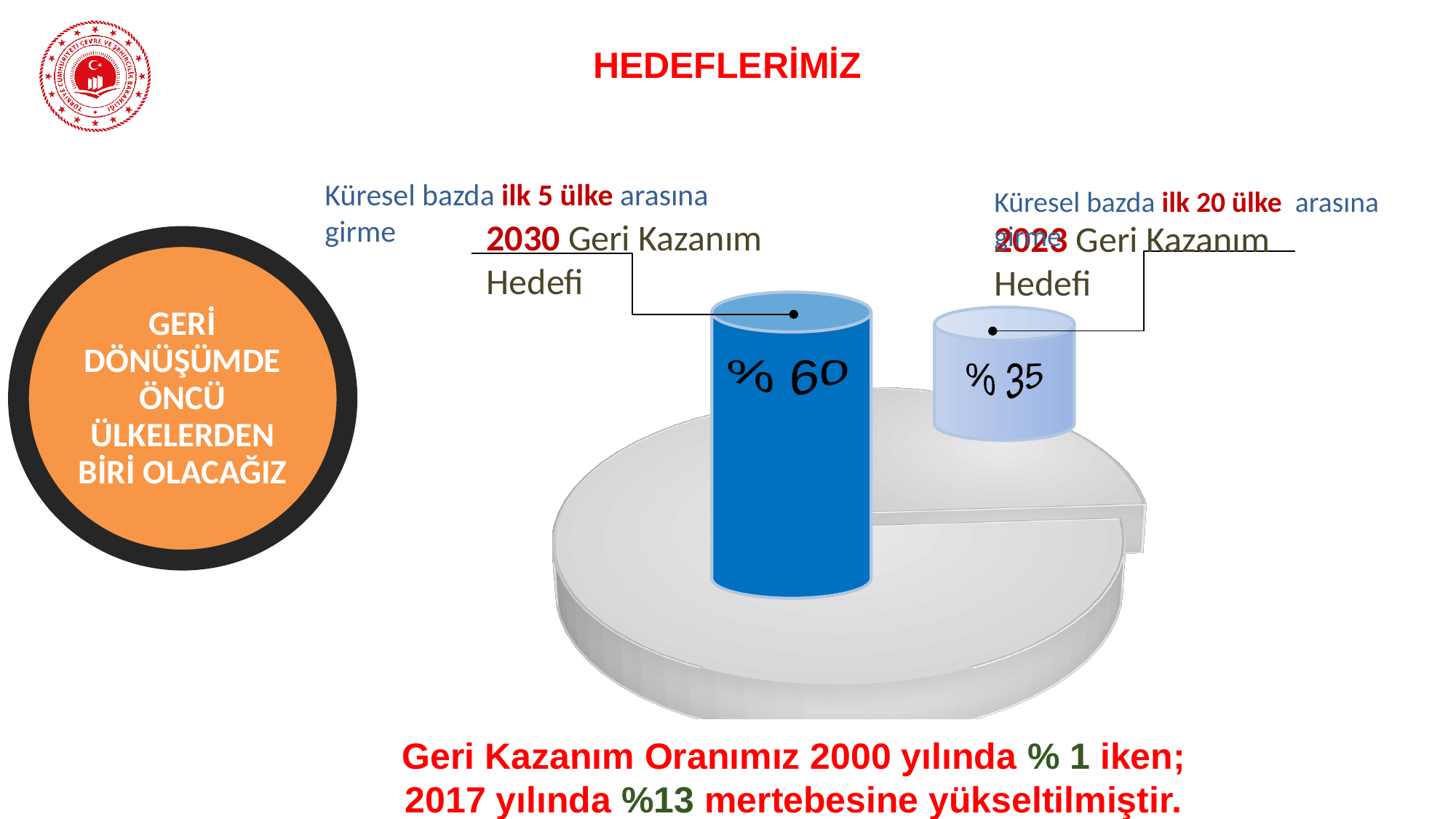
Is the value for the 2023 Geri Kazanım Hedefi larger or smaller than the value for the 2030 Geri Kazanım Hedefi? smaller Which target has the lower value on the chart? 2023 Geri Kazanım Hedefi What is the value shown on the taller cylinder for the 2030 Geri Kazanım Hedefi? % 60 Which target has the higher value, 2030 Geri Kazanım Hedefi or 2023 Geri Kazanım Hedefi? 2030 Geri Kazanım Hedefi What kind of chart is used to show the recovery targets? bar chart How many cylinders (data points) are plotted on the chart? 2 Which cylinder is drawn in the darker blue colour, the 2030 target or the 2023 target? 2030 target By how many percentage points does the 2030 target exceed the 2023 target? 25 What is the title at the top of the slide? HEDEFLERİMİZ What is the value shown on the shorter cylinder for the 2023 Geri Kazanım Hedefi? % 35 According to the text below the chart, what was the recovery rate in 2017? %13 According to the text below the chart, what was the recovery rate in 2000? % 1